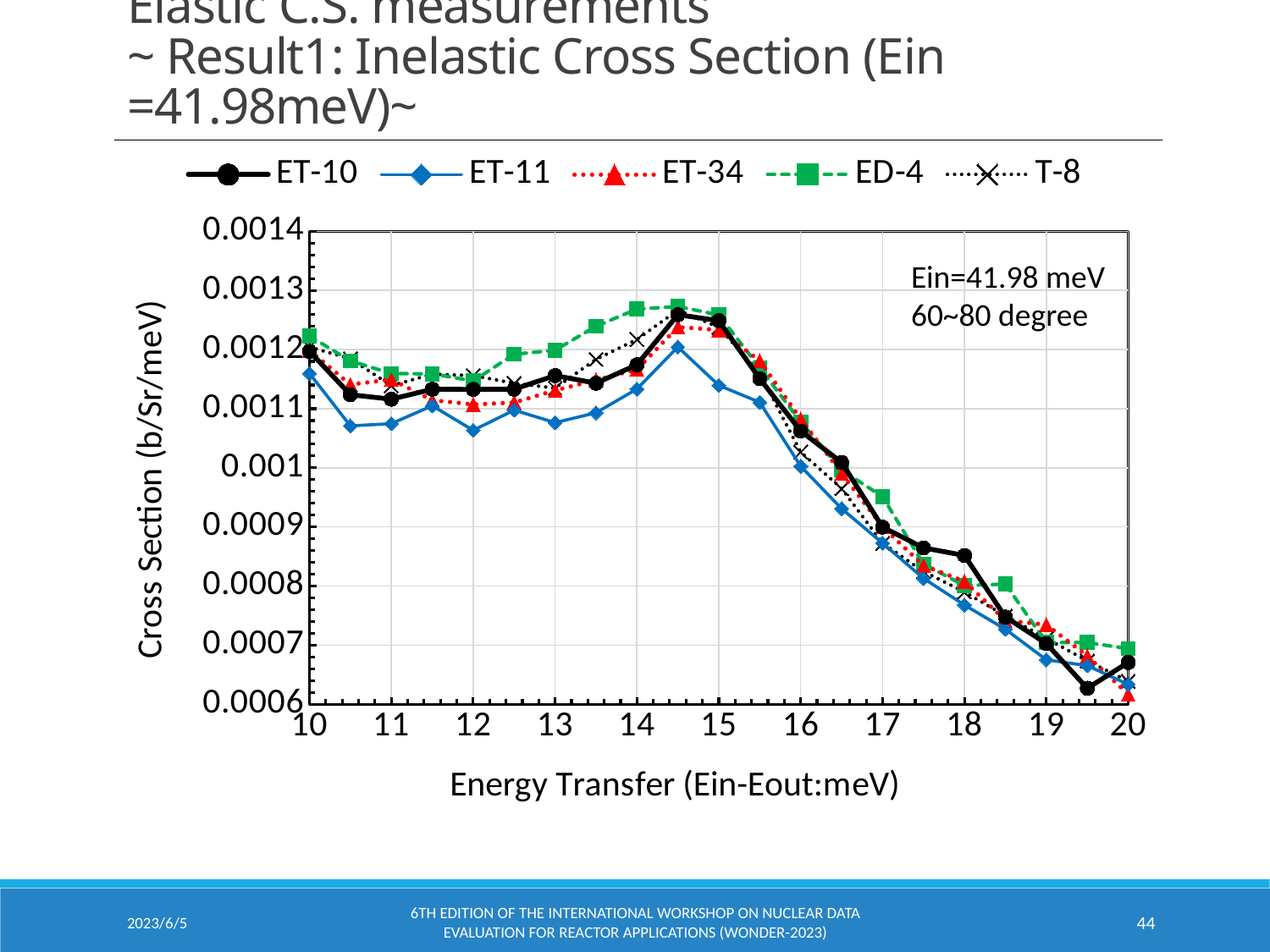
Do the values of the series rise or fall as the energy transfer increases from 15 meV to 19 meV? fall Is the value of ET-11 at an energy transfer of 10 meV greater or less than 0.0012? less What is the title of the y axis? Cross Section (b/Sr/meV) Is the value of ET-10 at an energy transfer of 20 meV greater or less than 0.0007? less How many series does the chart legend list? 5 What is the title of the x axis? Energy Transfer (Ein-Eout:meV) What kind of chart is shown on the slide? line chart At an energy transfer of 14.5 meV, which series has the larger value, ED-4 or ET-11? ED-4 Is the value of ET-11 at an energy transfer of 12 meV greater or less than 0.0011? less At an energy transfer of 18 meV, which series has the larger value, ET-10 or ET-11? ET-10